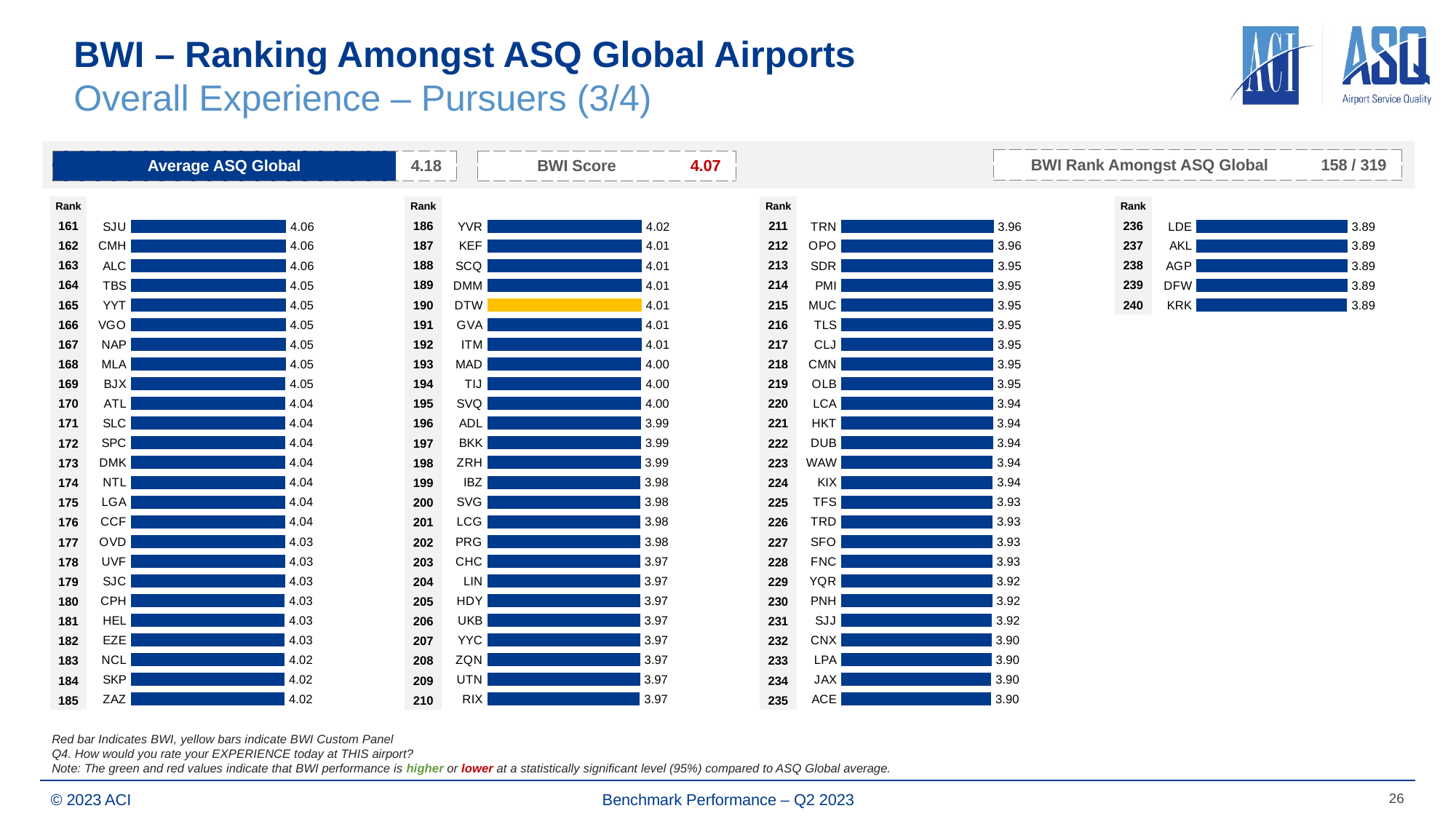
How many airports are plotted in the leftmost chart (ranks 161-185)? 25 In the leftmost chart (ranks 161-185), what rank is shown for ATL? 170 In the second chart from the left (ranks 186-210), which has the larger value, YVR or RIX? YVR In the leftmost chart (ranks 161-185), what is the difference between the values for SJU and ZAZ? 0.04 In the second chart from the left (ranks 186-210), what is the value for DTW? 4.01 What kind of chart is used to show the airport scores on this slide? Bar chart In the third chart from the left (ranks 211-235), what is the value for ACE? 3.90 In the third chart from the left (ranks 211-235), do the values rise or fall from the top row to the bottom row? Fall In the second chart from the left (ranks 186-210), which airport's bar is coloured yellow? DTW In the rightmost chart (ranks 236-240), what is the value for KRK? 3.89 In the leftmost chart (ranks 161-185), what is the value for SJU? 4.06 How many airports are plotted in the rightmost chart (ranks 236-240)? 5